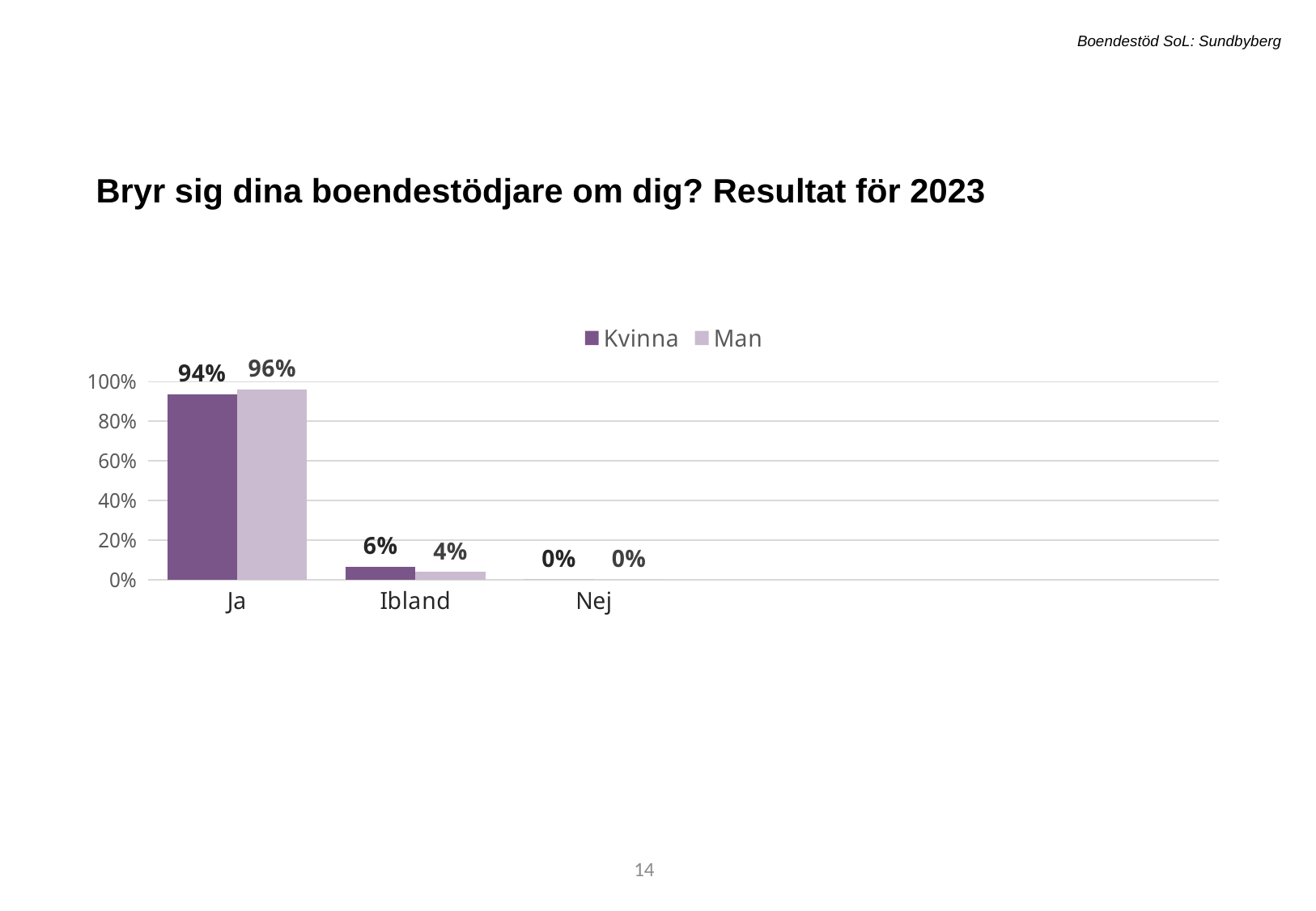
What is the difference between the Man and Kvinna values in the Ja category? 2% What is the value for Kvinna in the Ibland category? 6% Is the value for Kvinna in the Ja category greater or less than 80%? greater Which category has the highest value for the Kvinna series? Ja What kind of chart is shown on the slide? Bar chart In the Ibland category, which series has the larger value, Kvinna or Man? Kvinna Which category has the lowest value for the Man series? Nej How many categories are shown on the x axis? 3 How many series does the legend list? 2 What is the value for Kvinna in the Ja category? 94% What is the value for Man in the Ja category? 96% What is the value for Man in the Nej category? 0%